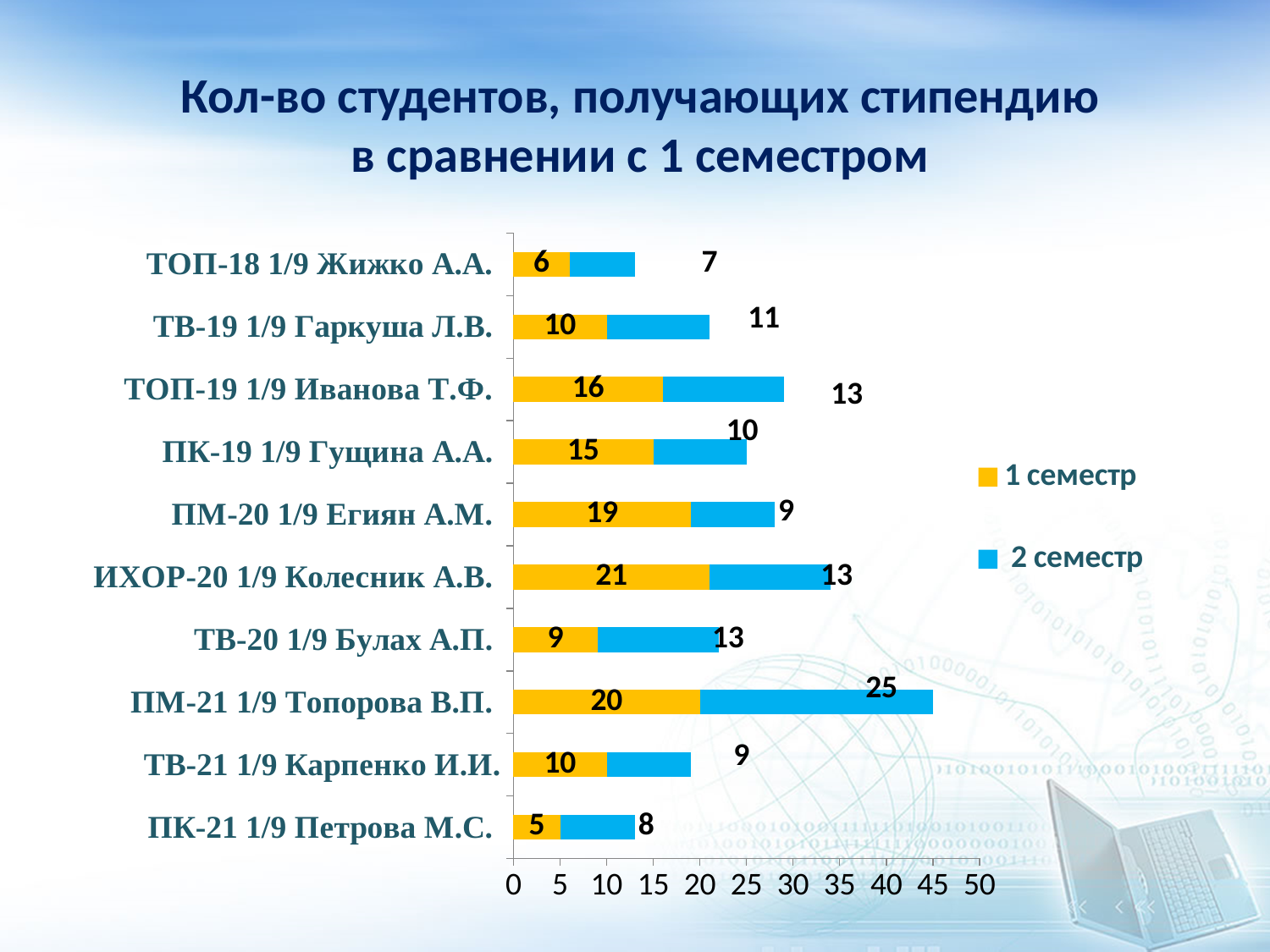
What is the value for 2 семестр for ПМ-21 1/9 Топорова В.П.? 25 Which colour represents 1 семестр in the legend? Yellow What is the difference between the 1 семестр and 2 семестр values for ПМ-20 1/9 Егиян А.М.? 10 What is the total of the stacked bar for ПМ-21 1/9 Топорова В.П.? 45 How many groups (categories) are shown on the chart? 10 What type of chart is shown on the slide? Stacked bar chart What is the value for 1 семестр for ИХОР-20 1/9 Колесник А.В.? 21 What is the value for 1 семестр for ПК-21 1/9 Петрова М.С.? 5 Which group has the lowest value for 1 семестр? ПК-21 1/9 Петрова М.С. Which group has the highest value for 2 семестр? ПМ-21 1/9 Топорова В.П. How many series does the legend list? 2 For ТВ-20 1/9 Булах А.П., which is larger: the 1 семестр value or the 2 семестр value? 2 семестр